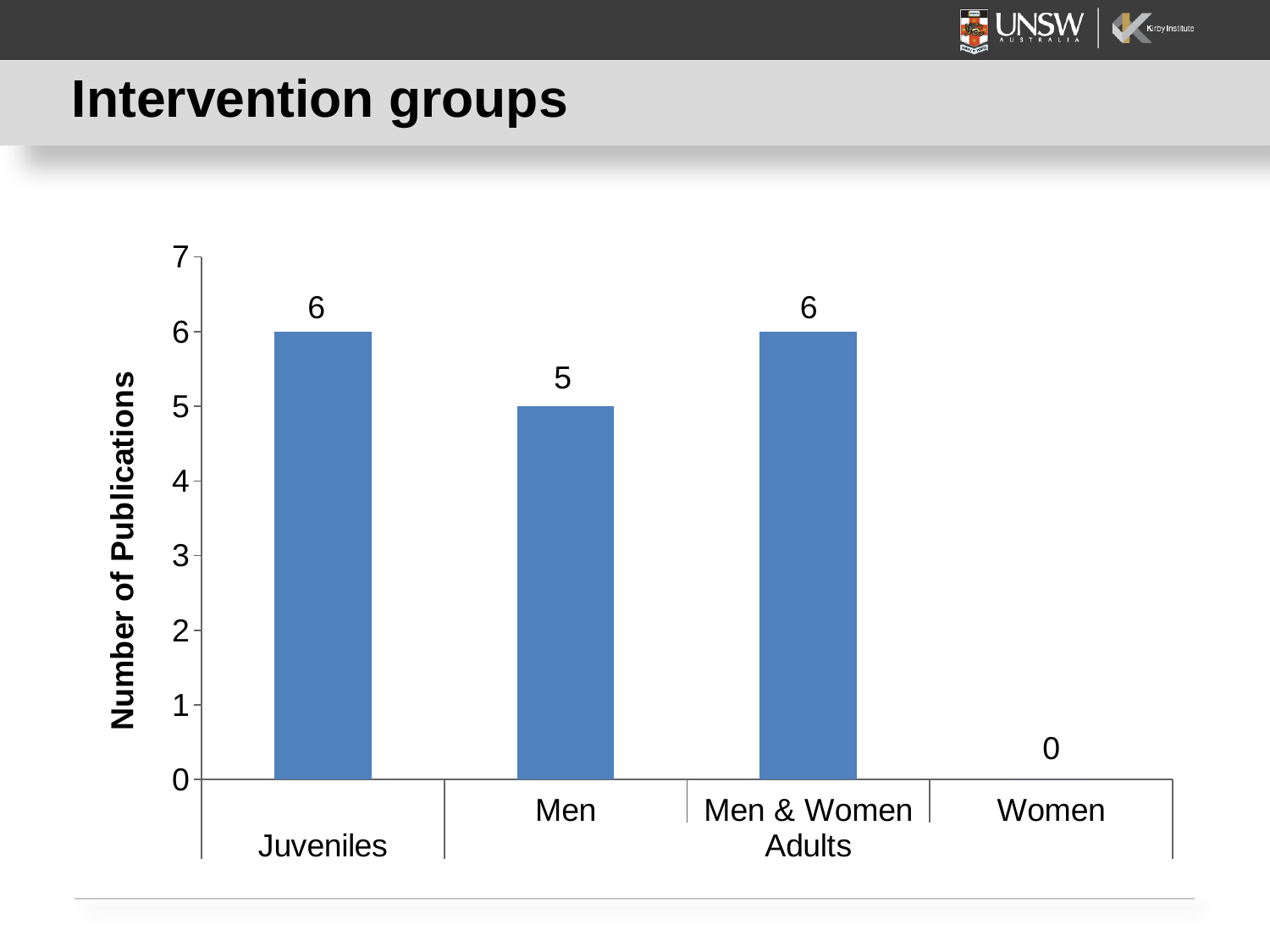
Which has more publications, Men or Men & Women? Men & Women What is the title of the slide containing the chart? Intervention groups How many publications are shown for Men & Women? 6 What is the difference in number of publications between Juveniles and Men? 1 How many publications are shown for Men? 5 How many publications are shown for Women? 0 Which category has the lowest number of publications? Women How many publications are shown for Juveniles? 6 What is the label of the y axis? Number of Publications What is the difference in number of publications between Men and Women? 5 What kind of chart is shown on the slide? Bar chart How many categories are shown on the x axis? 4